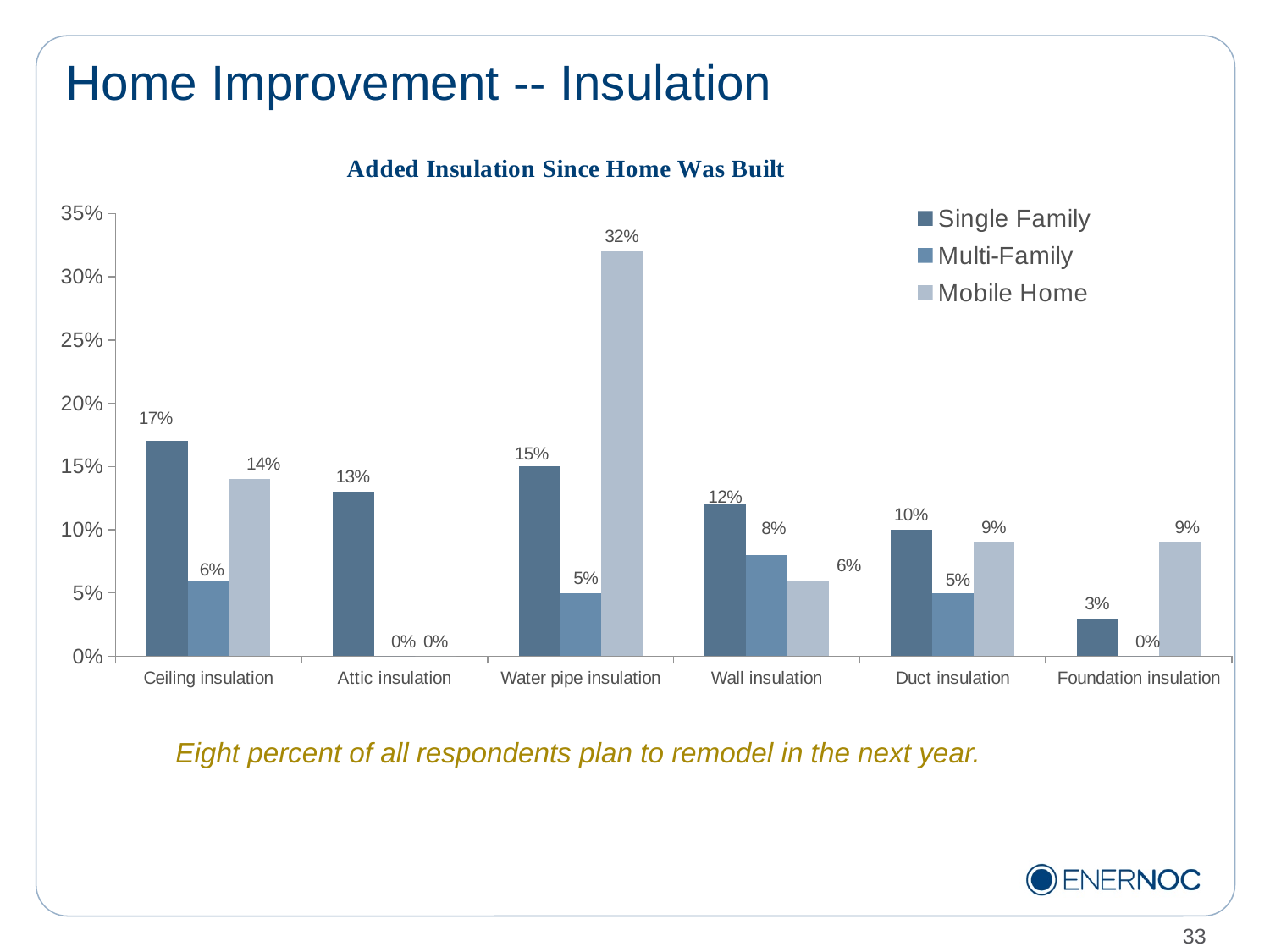
Which is larger for Duct insulation: the Single Family value or the Mobile Home value? Single Family What is the Single Family value for Ceiling insulation? 17% How many series does the legend list? 3 How many insulation categories are shown on the x axis? 6 What kind of chart is shown on the slide? Bar chart What is the title of the chart? Added Insulation Since Home Was Built What is the difference between the Mobile Home and Single Family values for Water pipe insulation? 17% Is the Mobile Home value for Water pipe insulation greater or less than 30%? greater Which category has the highest Single Family value? Ceiling insulation What is the Mobile Home value for Water pipe insulation? 32% Which category has the lowest Single Family value? Foundation insulation What is the Multi-Family value for Wall insulation? 8%